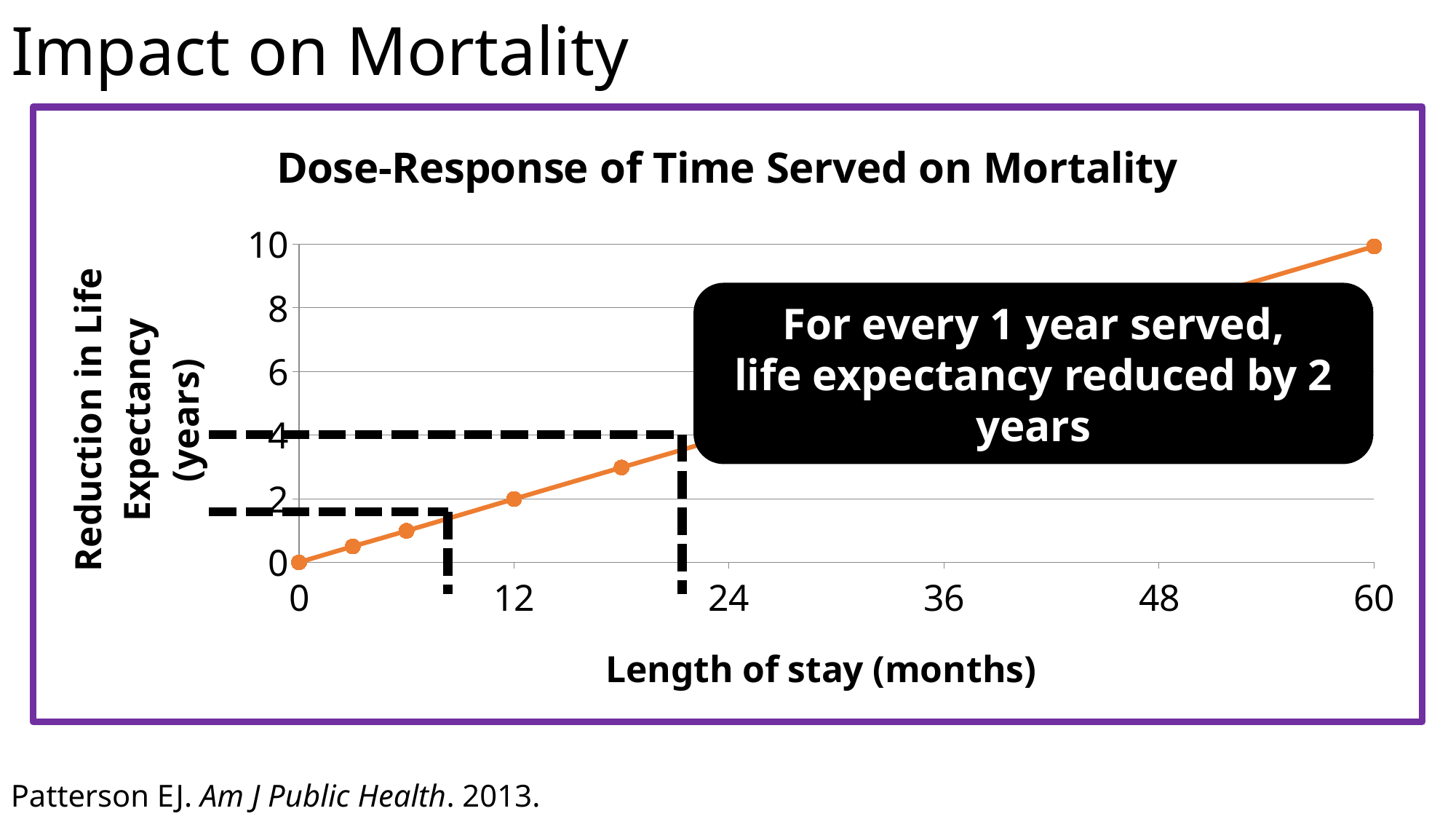
What kind of chart is shown on the slide? Line chart At which length of stay is the reduction in life expectancy highest? 60 months Do the plotted values rise or fall as length of stay increases? Rise What reduction in life expectancy is plotted for a length of stay of 0 months? 0 According to the callout on the chart, by how many years is life expectancy reduced for every 1 year served? 2 years At which length of stay is the reduction in life expectancy lowest? 0 months What is the title of the chart? Dose-Response of Time Served on Mortality Is the reduction in life expectancy at 18 months greater or less than 4? less